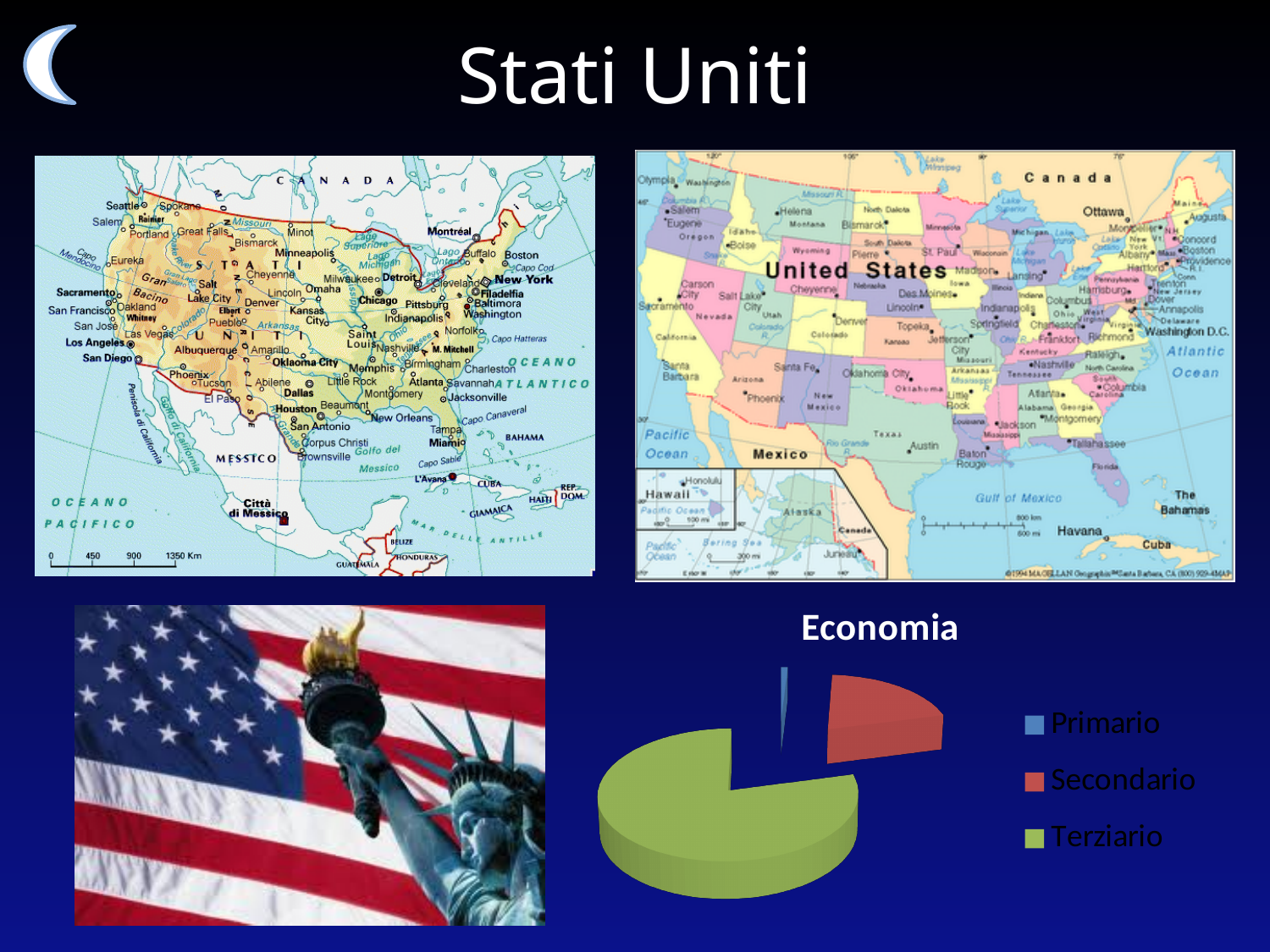
In the "Economia" pie chart, which is larger: Secondario or Terziario? Terziario Which sector has the largest slice in the "Economia" pie chart? Terziario How many entries does the legend of the "Economia" chart list? 3 What is the title of the chart on the slide? Economia What colour represents Terziario in the "Economia" pie chart? green How many slices does the "Economia" pie chart have? 3 In the "Economia" pie chart, which is larger: Primario or Secondario? Secondario Which legend entry of the "Economia" chart is shown in red? Secondario Which sector has the smallest slice in the "Economia" pie chart? Primario What kind of chart is shown under the title "Economia"? pie chart